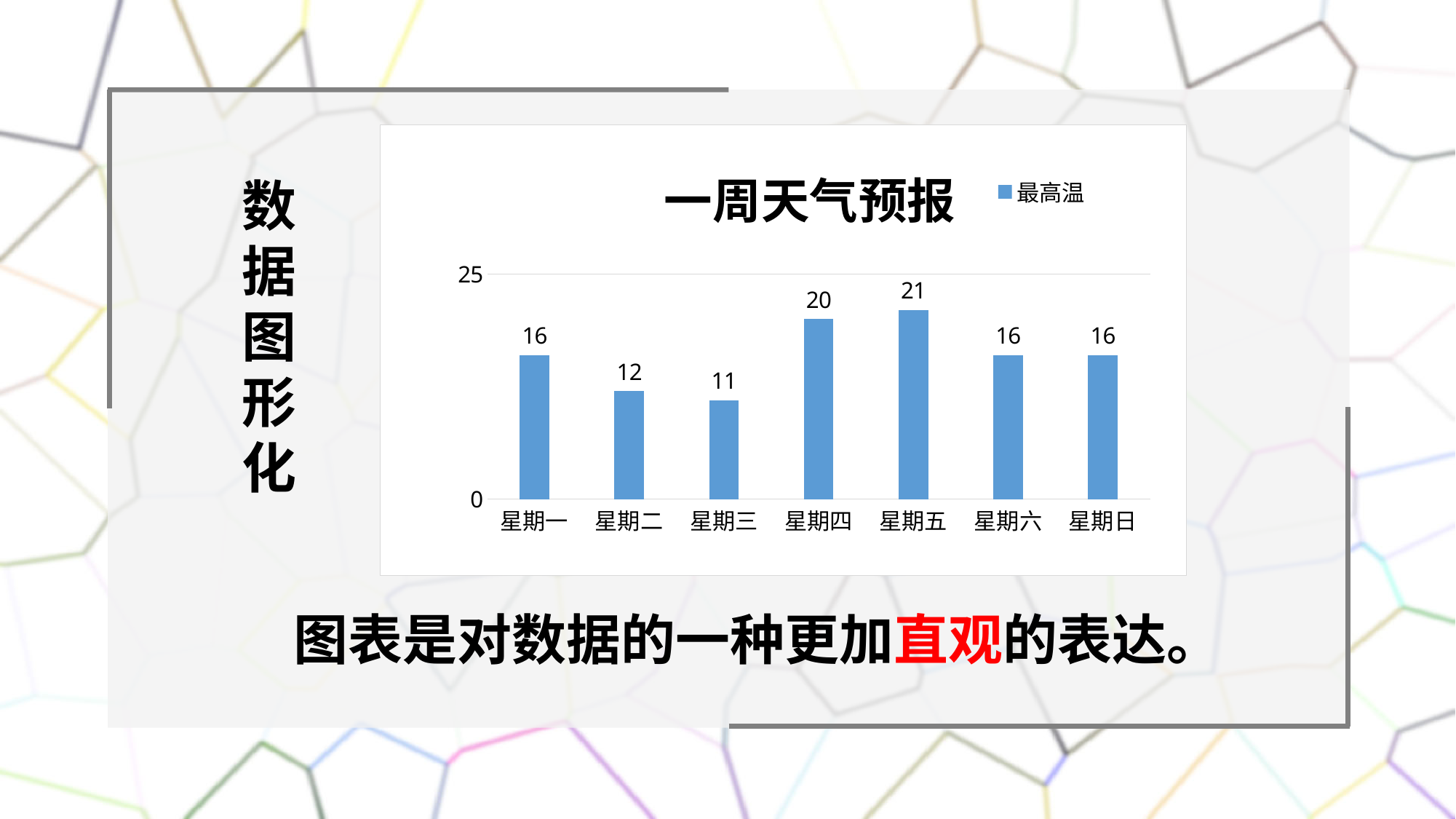
Which day has the highest value in the 一周天气预报 chart? 星期五 What is the value for 星期一 in the 一周天气预报 chart? 16 What kind of chart is shown on the slide? bar chart How many series does the legend list? 1 What is the difference between the values for 星期五 and 星期三? 10 Which is larger, the value for 星期四 or the value for 星期一? 星期四 What is the value for 星期五 in the 一周天气预报 chart? 21 What is the title of the chart? 一周天气预报 Which day has the lowest value in the 一周天气预报 chart? 星期三 What is the difference between the values for 星期四 and 星期二? 8 How many days are shown on the x axis of the chart? 7 What is the value for 星期三 in the 一周天气预报 chart? 11